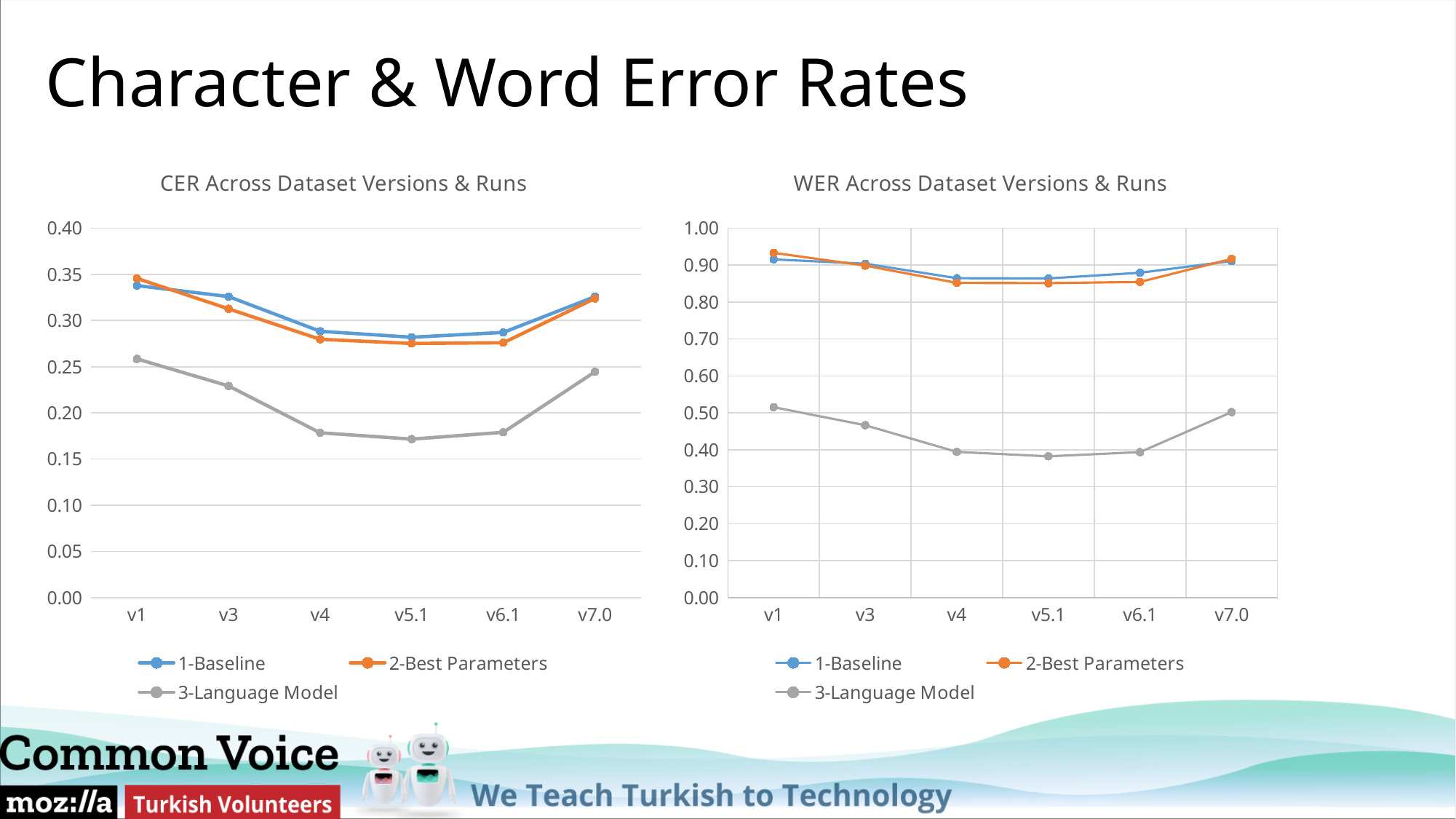
Which series is drawn in grey in the WER Across Dataset Versions & Runs chart? 3-Language Model How many dataset versions are shown on the x axis of the WER Across Dataset Versions & Runs chart? 6 What kind of chart is the CER Across Dataset Versions & Runs chart? line chart In the WER Across Dataset Versions & Runs chart, does the 3-Language Model line rise or fall from v1 to v4? fall In the CER Across Dataset Versions & Runs chart, which dataset version has the highest 2-Best Parameters value? v1 In the WER Across Dataset Versions & Runs chart, is the 3-Language Model value at v3 greater or less than 0.50? less In the WER Across Dataset Versions & Runs chart, is the 2-Best Parameters value at v4 greater or less than 0.90? less In the CER Across Dataset Versions & Runs chart, is the 3-Language Model value at v1 greater or less than 0.25? greater In the CER Across Dataset Versions & Runs chart, at v3, which is larger: 1-Baseline or 2-Best Parameters? 1-Baseline How many series does the legend of the CER Across Dataset Versions & Runs chart list? 3 In the CER Across Dataset Versions & Runs chart, which series has the lowest value at v1? 3-Language Model